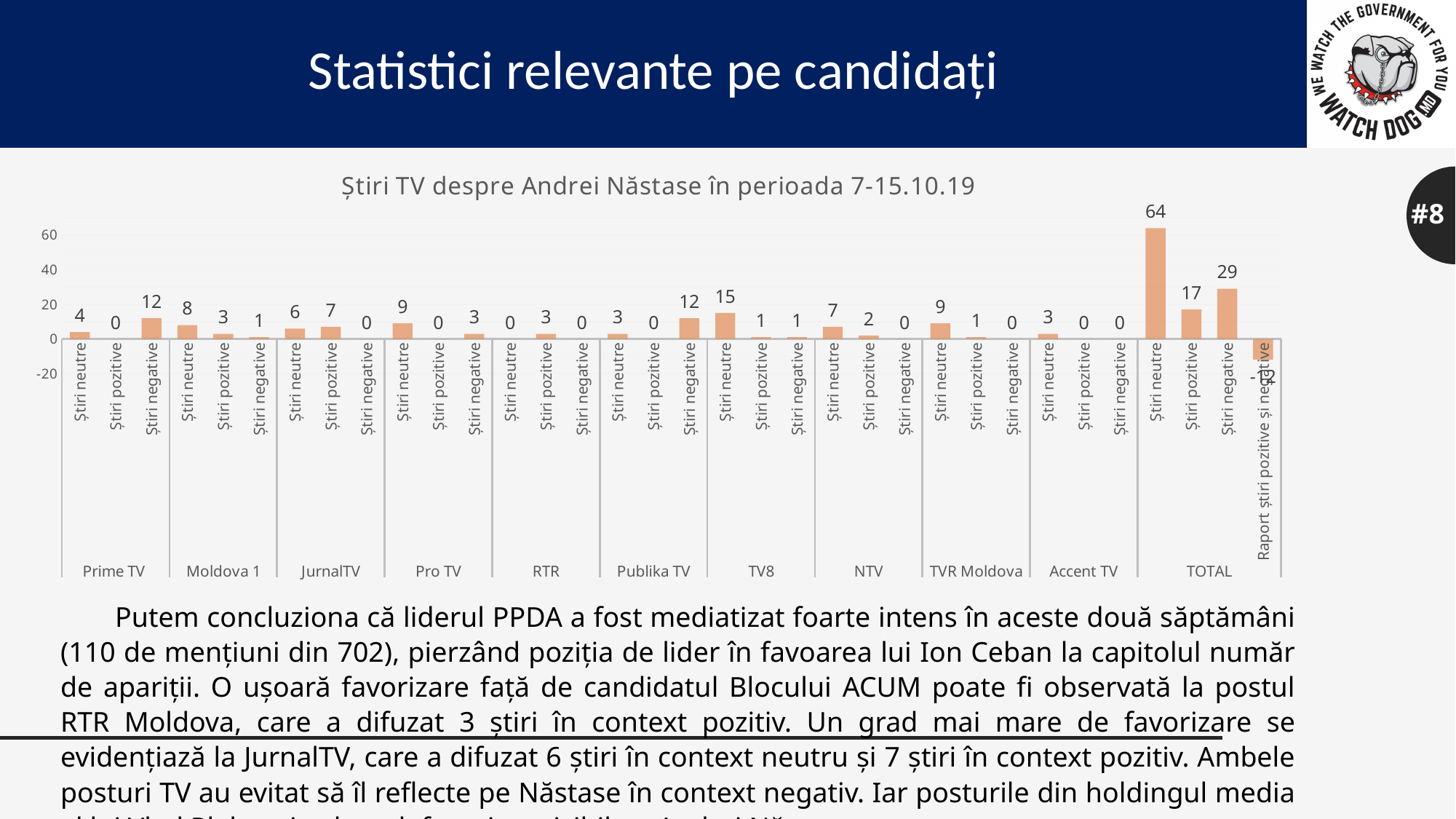
What is the total of 'Știri neutre', 'Știri pozitive' and 'Știri negative' for Moldova 1? 12 How many 'Știri negative' were reported for Prime TV? 12 How many TV station groups are shown on the x axis, including TOTAL? 11 Which TV station has the highest number of 'Știri neutre' (excluding TOTAL)? TV8 What is the value of 'Raport știri pozitive și negative' in the TOTAL group? -12 What is the title of the chart? Știri TV despre Andrei Năstase în perioada 7-15.10.19 Which is larger: 'Știri neutre' for Moldova 1 or 'Știri neutre' for Pro TV? Pro TV What is the value of 'Știri pozitive' for JurnalTV? 7 What is the difference between 'Știri negative' and 'Știri pozitive' in the TOTAL group? 12 What is the value of 'Știri neutre' in the TOTAL group? 64 What is the value of 'Știri neutre' for TV8? 15 What type of chart is shown on the slide? bar chart